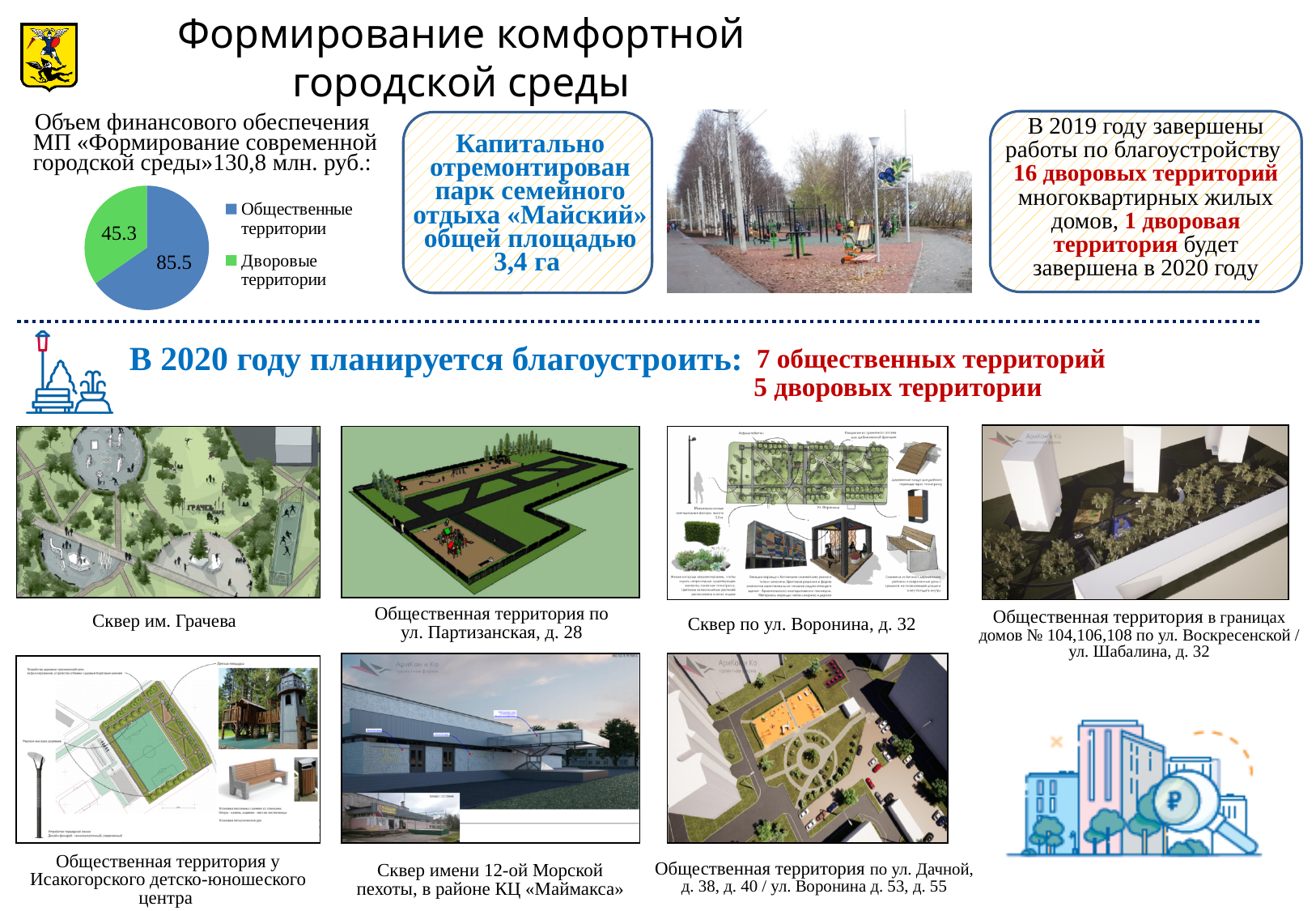
Which category in the pie chart has the largest value? Общественные территории Which is larger in the pie chart: Общественные территории or Дворовые территории? Общественные территории How many slices does the pie chart have? 2 What type of chart is shown on the slide? pie chart What colour is the Общественные территории slice in the pie chart? blue How many entries does the pie chart legend list? 2 In the pie chart, what is the value for Дворовые территории? 45.3 In the pie chart, what is the value for Общественные территории? 85.5 What is the difference between the values for Общественные территории and Дворовые территории in the pie chart? 40.2 What colour is the Дворовые территории slice in the pie chart? green What is the total of the two values shown in the pie chart? 130.8 Which category in the pie chart has the smallest value? Дворовые территории